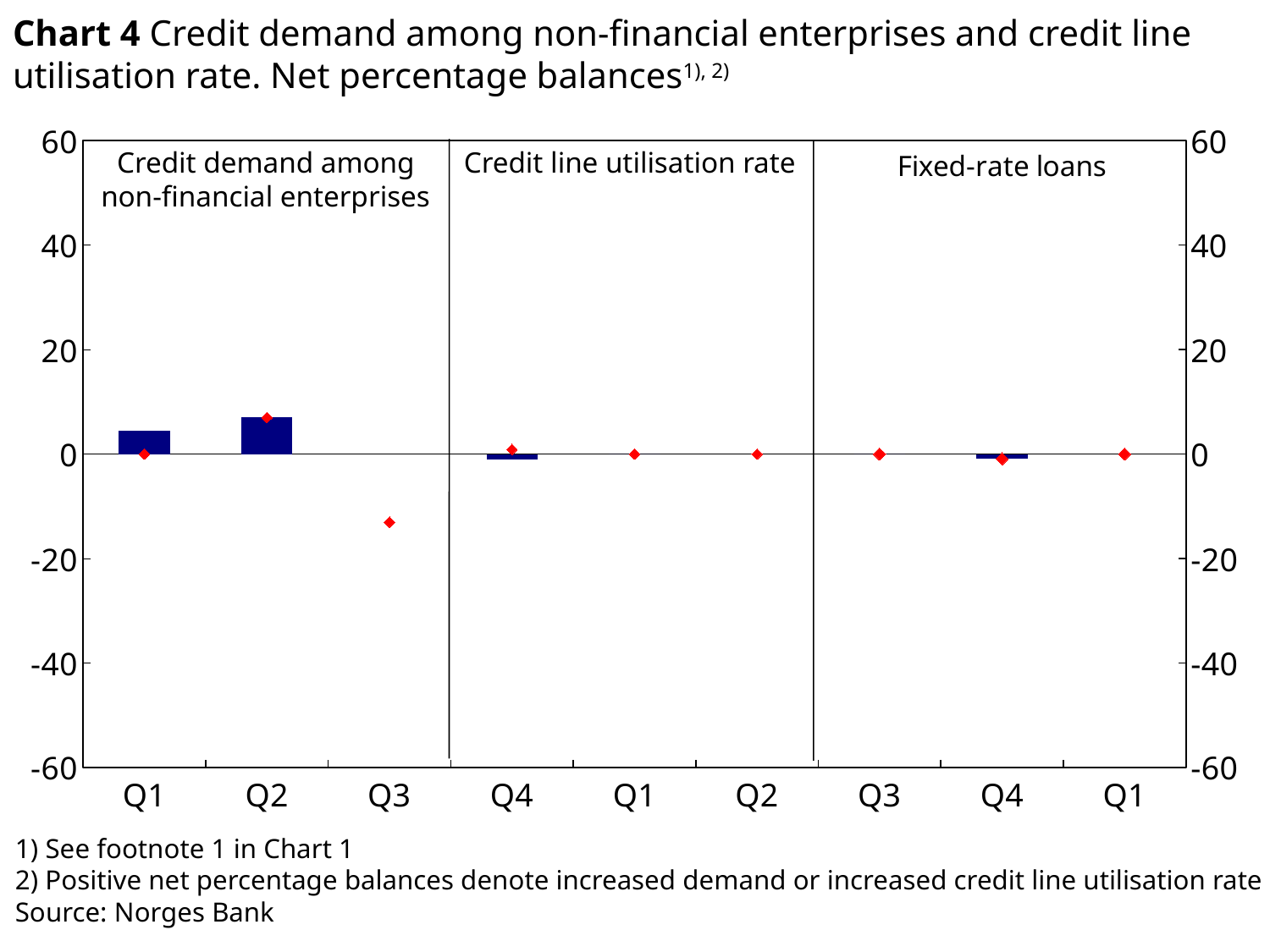
Is the red marker for Q3 in the 'Credit demand among non-financial enterprises' panel greater or less than -20? greater Which quarter has the lowest red marker on the whole chart? Q3 in the 'Credit demand among non-financial enterprises' panel What is the source given for the chart? Norges Bank Is the bar for Q2 in the 'Credit demand among non-financial enterprises' panel greater or less than 20? less In the 'Credit demand among non-financial enterprises' panel, is the bar for Q1 or the bar for Q2 taller? Q2 How many quarter labels are shown along the x axis? 9 Is the bar for Q1 in the 'Credit demand among non-financial enterprises' panel greater or less than 0? greater In the 'Credit demand among non-financial enterprises' panel, which quarter has the highest bar? Q2 Do the bars in the 'Credit demand among non-financial enterprises' panel rise or fall from Q1 to Q2? rise What kind of chart is shown on the slide? combination bar and line chart (bars with red diamond markers) How many panels (sections) is the chart divided into? 3